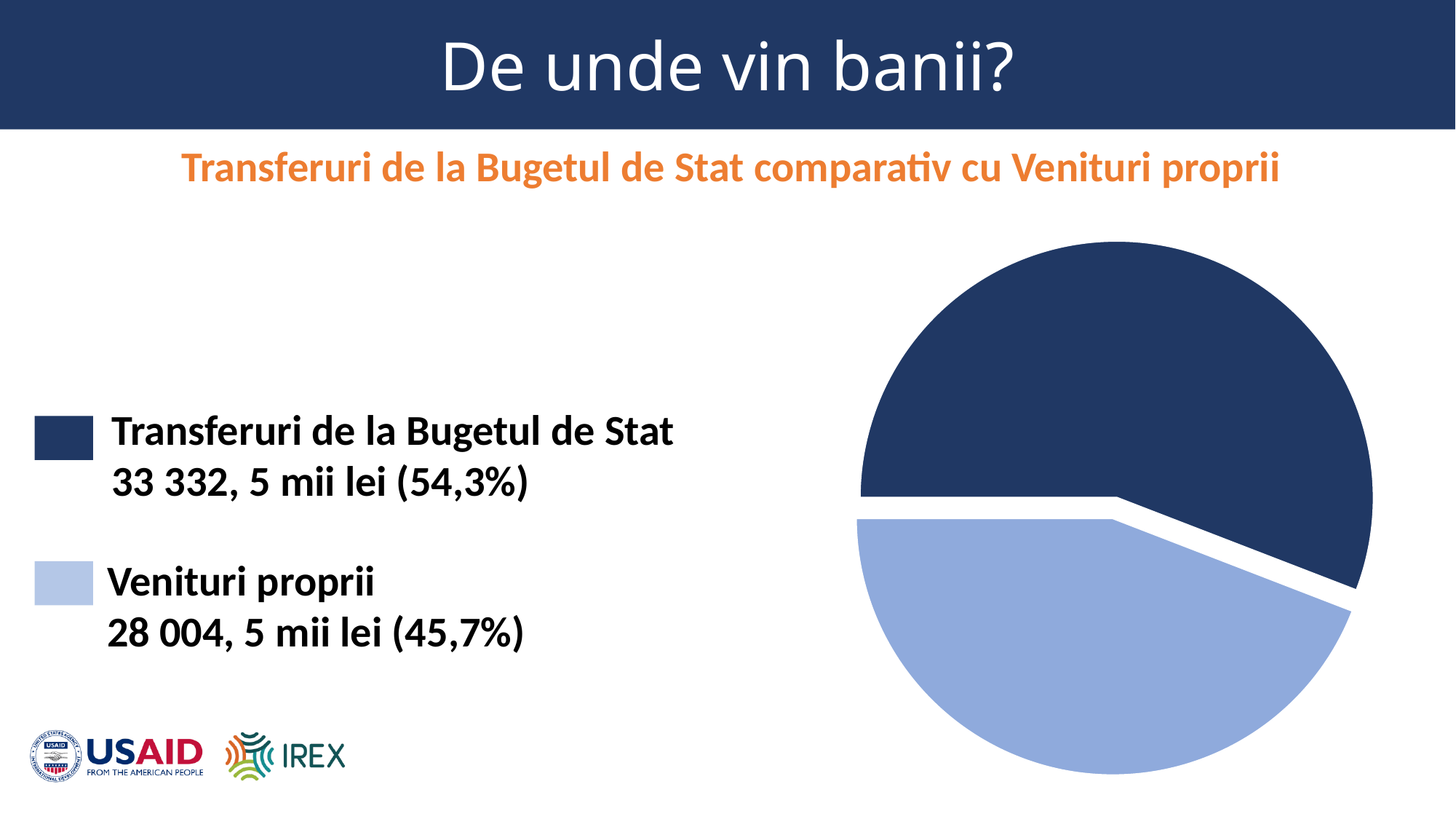
Which category has the smaller slice of the pie? Venituri proprii What share of the pie does Transferuri de la Bugetul de Stat represent? 54,3% What is the subtitle of the chart shown in orange text? Transferuri de la Bugetul de Stat comparativ cu Venituri proprii Which colour represents Venituri proprii in the pie chart? Light blue Which is larger, Transferuri de la Bugetul de Stat or Venituri proprii? Transferuri de la Bugetul de Stat What kind of chart is shown on the slide? Pie chart Which category has the larger slice of the pie? Transferuri de la Bugetul de Stat What is the value for Transferuri de la Bugetul de Stat? 33 332, 5 mii lei What is the difference in percentage points between Transferuri de la Bugetul de Stat and Venituri proprii? 8,6 percentage points What share of the pie does Venituri proprii represent? 45,7% How many slices does the pie chart have? 2 What is the value for Venituri proprii? 28 004, 5 mii lei